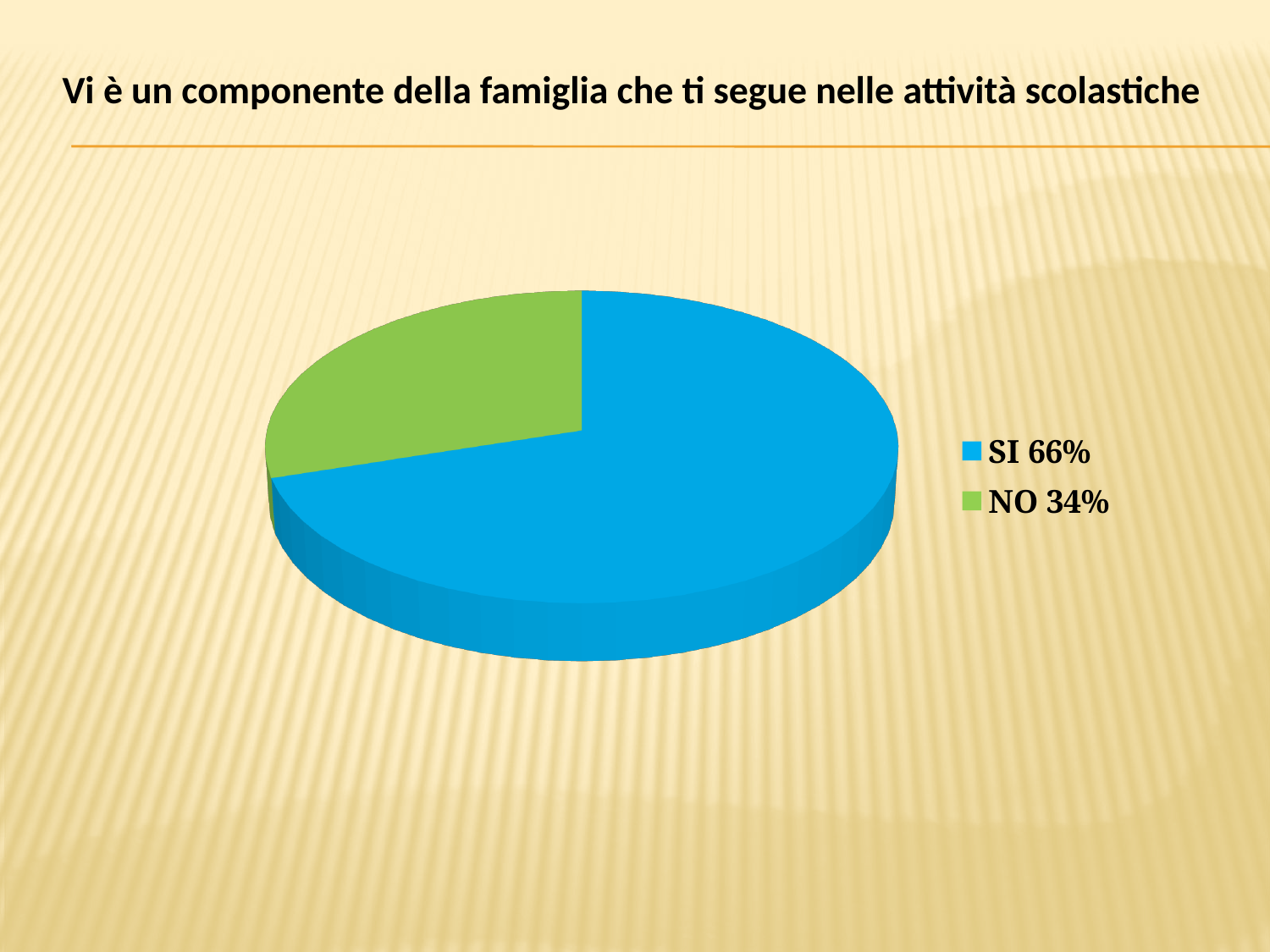
What share of the pie does SI represent? 66% What is the difference in percentage points between SI and NO? 32 How many categories does the pie chart show? 2 What kind of chart is shown on the slide? pie chart What colour is the NO slice? green How many entries does the legend list? 2 Which is larger, the SI slice or the NO slice? SI What share of the pie does NO represent? 34% Which category has the largest slice of the pie? SI What colour is the SI slice? blue Which category has the smallest slice of the pie? NO